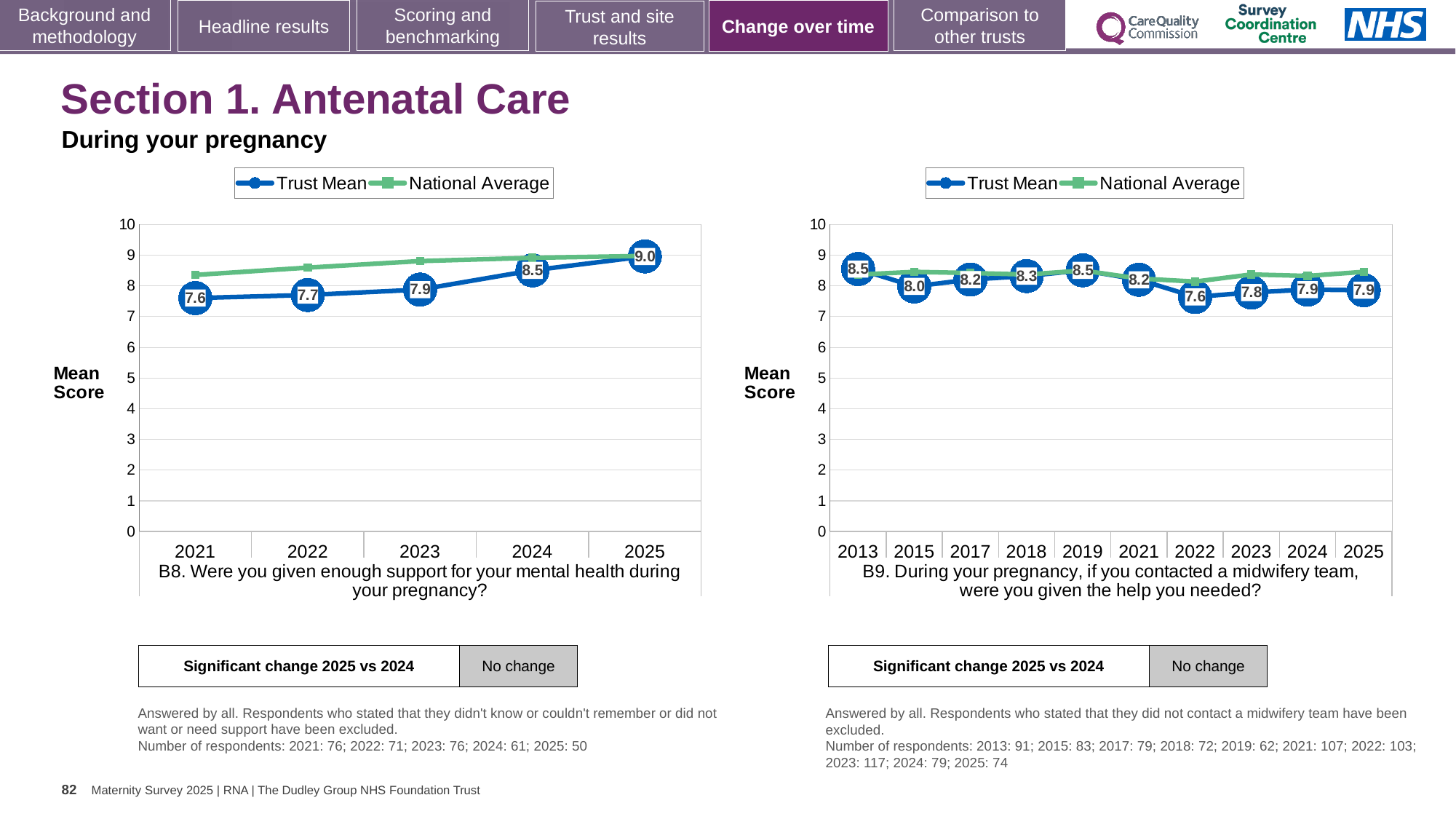
In the B9 chart (right), what is the Trust Mean for 2022? 7.6 In the B8 chart (left), which year has the highest Trust Mean? 2025 In the B8 chart (left), what is the Trust Mean for 2025? 9.0 In the B9 chart (right), what is the Trust Mean for 2018? 8.3 In the B8 chart (left), does the Trust Mean rise or fall from 2021 to 2025? rise In the B8 chart (left), what is the difference between the Trust Mean in 2025 and in 2021? 1.4 In the B9 chart (right), how many years are shown on the x axis? 10 In the B8 chart (left), what is the Trust Mean for 2021? 7.6 What kind of chart is the B9 chart (right)? line chart In the B9 chart (right), is the Trust Mean for 2013 larger or smaller than the Trust Mean for 2021? larger In the B9 chart (right), which year has the lowest Trust Mean? 2022 In the B8 chart (left), how many series does the legend list? 2